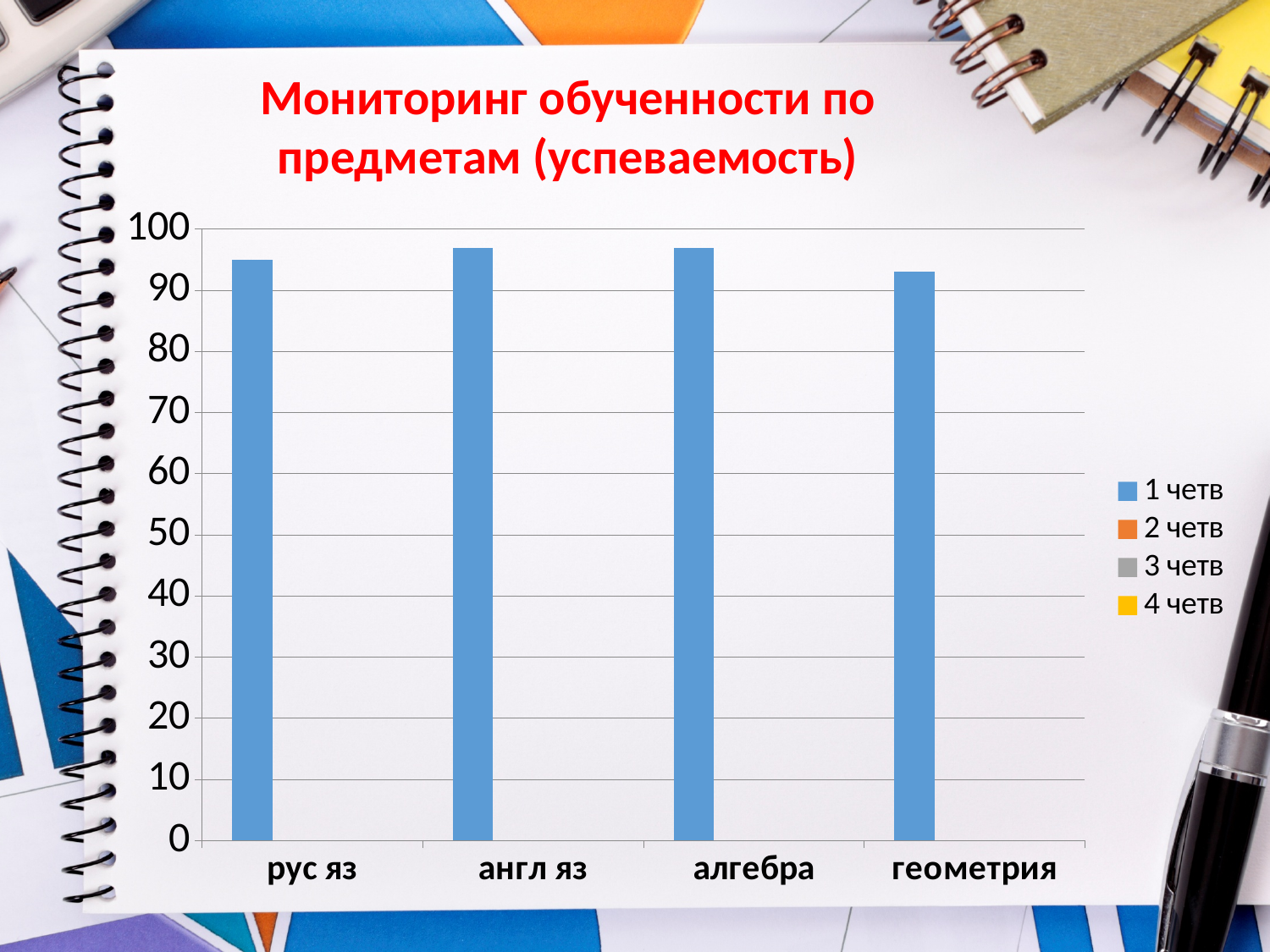
Which is larger, the value for англ яз or the value for геометрия? англ яз Which category has the lowest bar? геометрия Is the value for геометрия greater or less than 90? greater What is the title of the chart? Мониторинг обученности по предметам (успеваемость) Which is larger, the value for рус яз or the value for геометрия? рус яз Is the value for рус яз greater or less than 90? greater How many series does the legend list? 4 Is the value for англ яз greater or less than 100? less What kind of chart is shown on the slide? bar chart Which series in the legend is shown in blue? 1 четв How many categories are shown on the x axis? 4